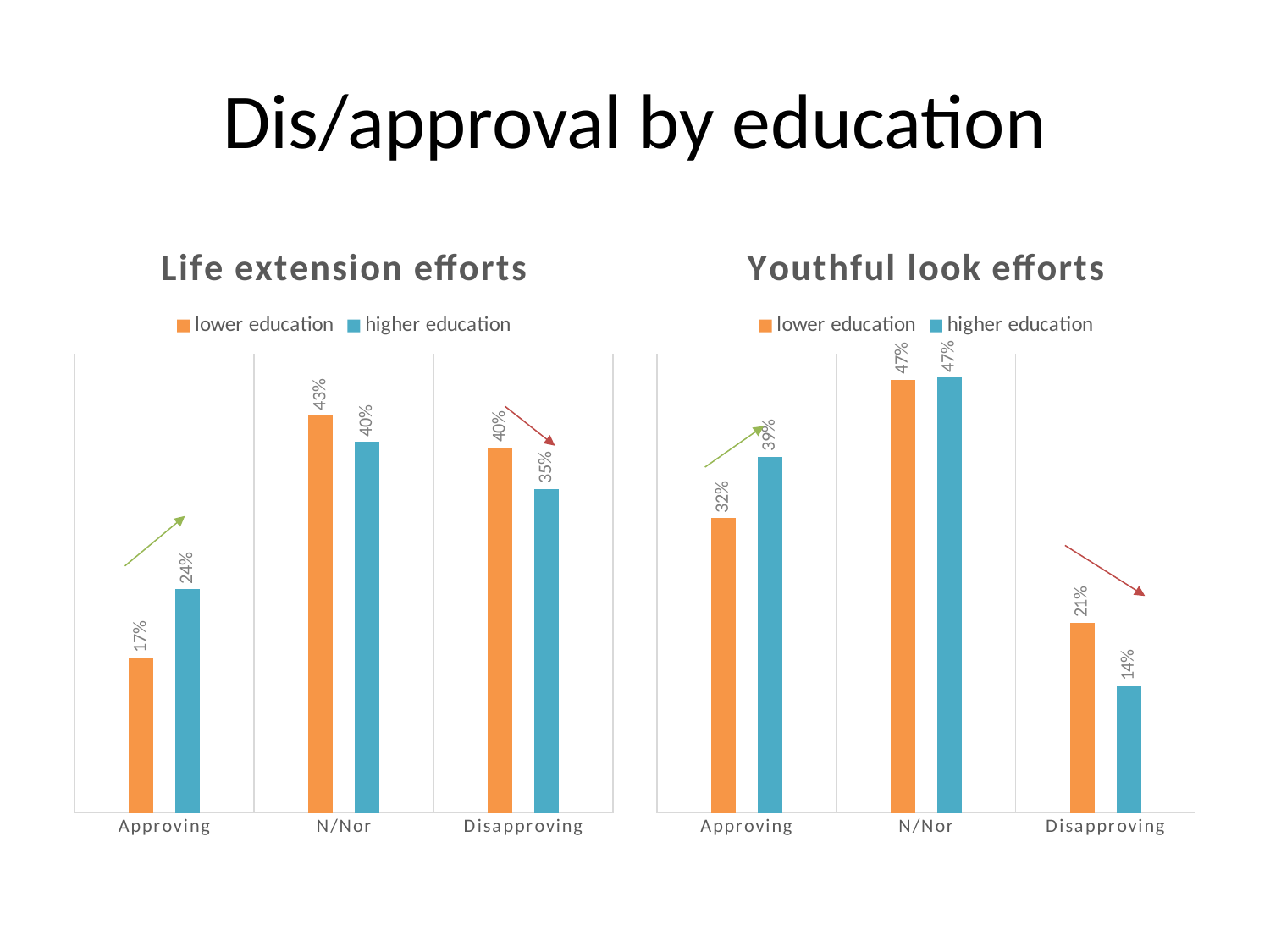
How many categories are shown on the x axis of the 'Youthful look efforts' chart? 3 In the 'Life extension efforts' chart, what is the value for higher education in the N/Nor category? 40% In the 'Life extension efforts' chart, which is larger in the Disapproving category: lower education or higher education? lower education How many series does the legend of the 'Life extension efforts' chart list? 2 In the 'Life extension efforts' chart, what is the difference between the higher education and lower education values in the Approving category? 7% In the 'Youthful look efforts' chart, what is the value for lower education in the Approving category? 32% In the 'Life extension efforts' chart, which category has the highest value for lower education? N/Nor What kind of chart is the 'Youthful look efforts' chart? bar chart In the 'Youthful look efforts' chart, which category has the lowest value for higher education? Disapproving In the 'Life extension efforts' chart, what is the value for lower education in the Approving category? 17% In the 'Youthful look efforts' chart, what is the value for higher education in the Disapproving category? 14% In the 'Youthful look efforts' chart, what is the difference between the lower education and higher education values in the Disapproving category? 7%